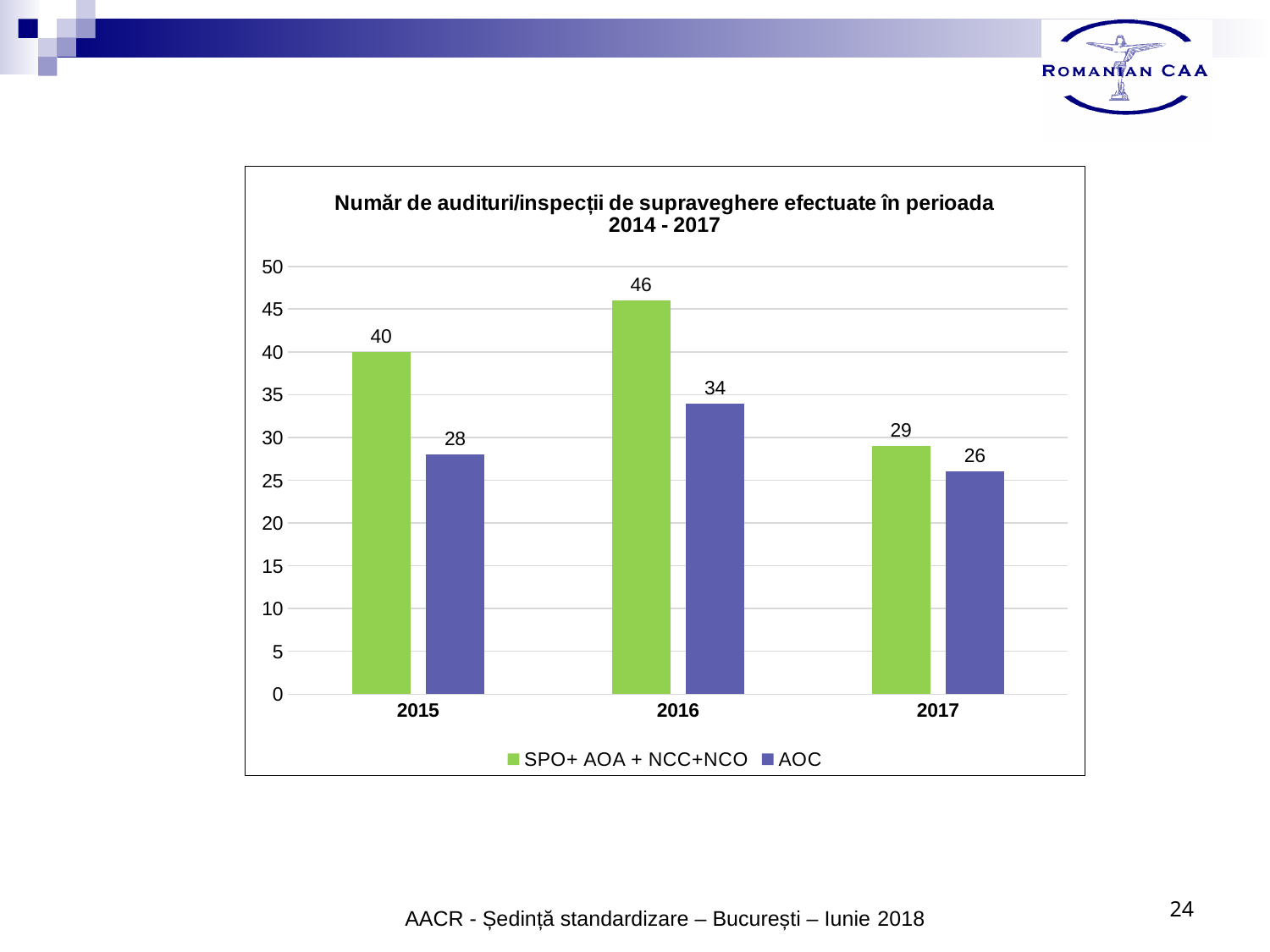
Does the AOC value rise or fall from 2016 to 2017? Fall What is the value for SPO+ AOA + NCC+NCO in 2016? 46 Which is larger in 2017: the SPO+ AOA + NCC+NCO value or the AOC value? SPO+ AOA + NCC+NCO What is the value for AOC in 2017? 26 How many series does the legend list? 2 What is the value for AOC in 2015? 28 In which year is the SPO+ AOA + NCC+NCO value highest? 2016 What kind of chart is shown on the slide? Bar chart How many years are shown on the x axis? 3 What is the difference between the SPO+ AOA + NCC+NCO value and the AOC value in 2015? 12 In which year is the AOC value lowest? 2017 What colour are the AOC bars? Blue/purple